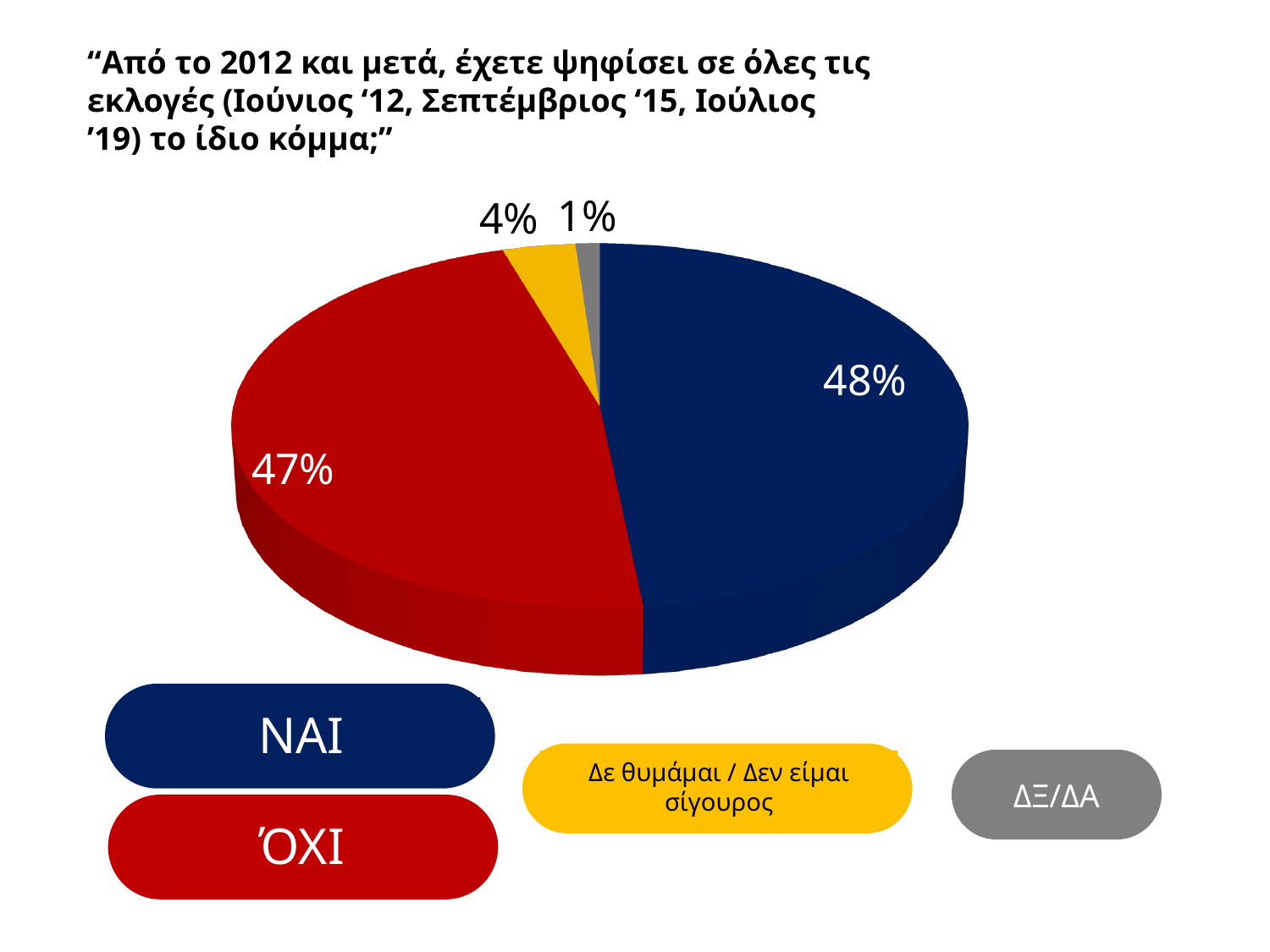
How many slices does the pie chart have? 4 What share of the pie is labelled 'Δε θυμάμαι / Δεν είμαι σίγουρος'? 4% What colour is the slice representing ΌΧΙ? Red What type of chart is shown on the slide? Pie chart What colour is the slice representing ΔΞ/ΔΑ? Grey Which response has the largest slice of the pie? ΝΑΙ Which is larger according to the printed labels, the ΝΑΙ slice or the ΌΧΙ slice? ΝΑΙ Which response has the smallest slice of the pie? ΔΞ/ΔΑ What percentage of respondents answered ΝΑΙ? 48% What is the difference in percentage points between the ΝΑΙ and ΌΧΙ slices? 1 percentage point What percentage of respondents answered ΌΧΙ? 47% What percentage is shown for ΔΞ/ΔΑ? 1%